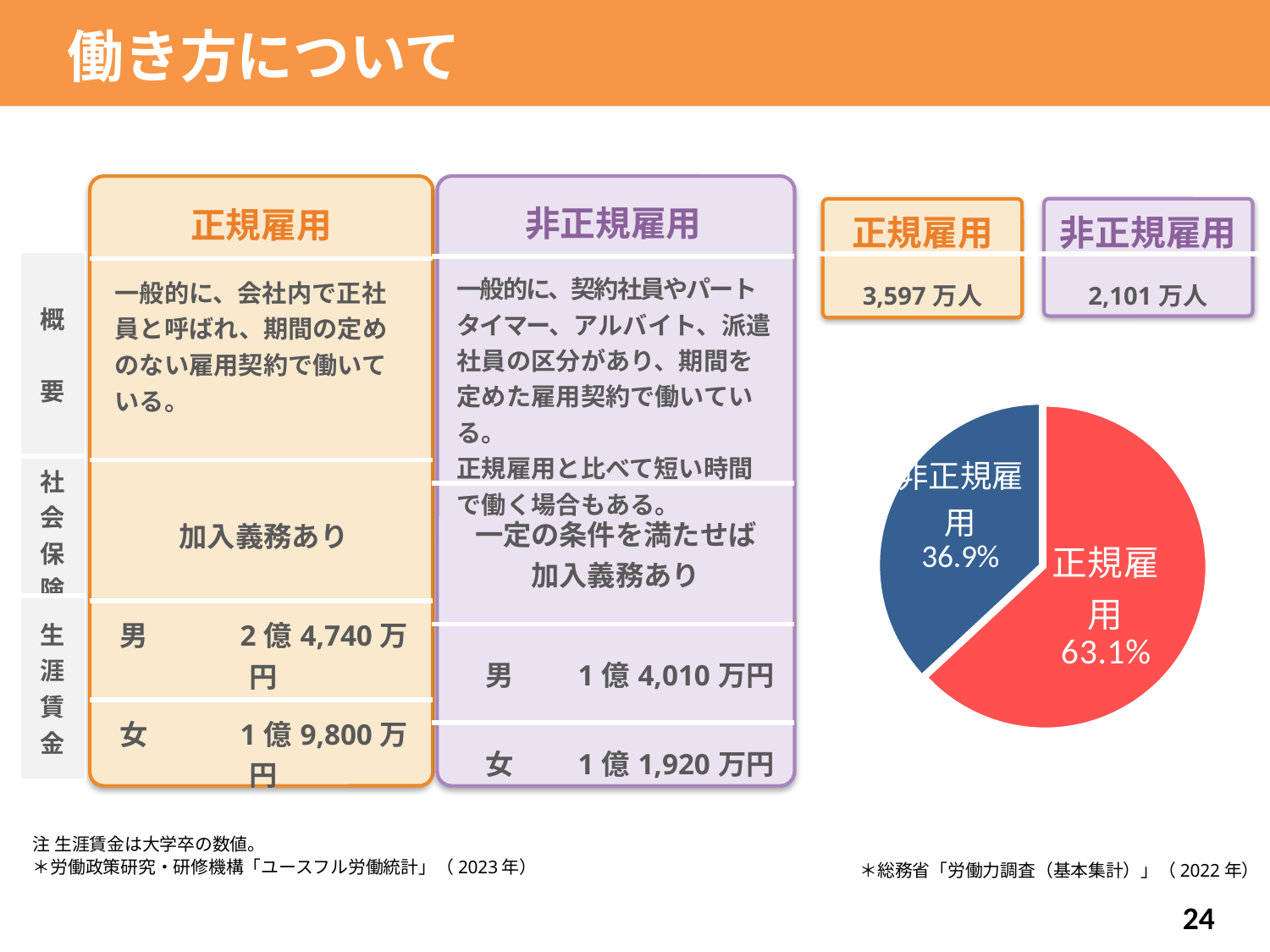
In the pie chart, which is larger: 正規雇用 or 非正規雇用? 正規雇用 What colour is the 非正規雇用 slice in the pie chart? blue How many slices does the pie chart have? 2 Which slice of the pie chart is the smallest? 非正規雇用 What is the difference in percentage points between the 正規雇用 slice and the 非正規雇用 slice in the pie chart? 26.2 In the pie chart, what share is labelled for 正規雇用? 63.1% What kind of chart is shown on the right side of the slide? pie chart What colour is the 正規雇用 slice in the pie chart? red Which slice of the pie chart is the largest? 正規雇用 In the pie chart, what share is labelled for 非正規雇用? 36.9% Is the share of 正規雇用 in the pie chart greater or less than 50%? greater